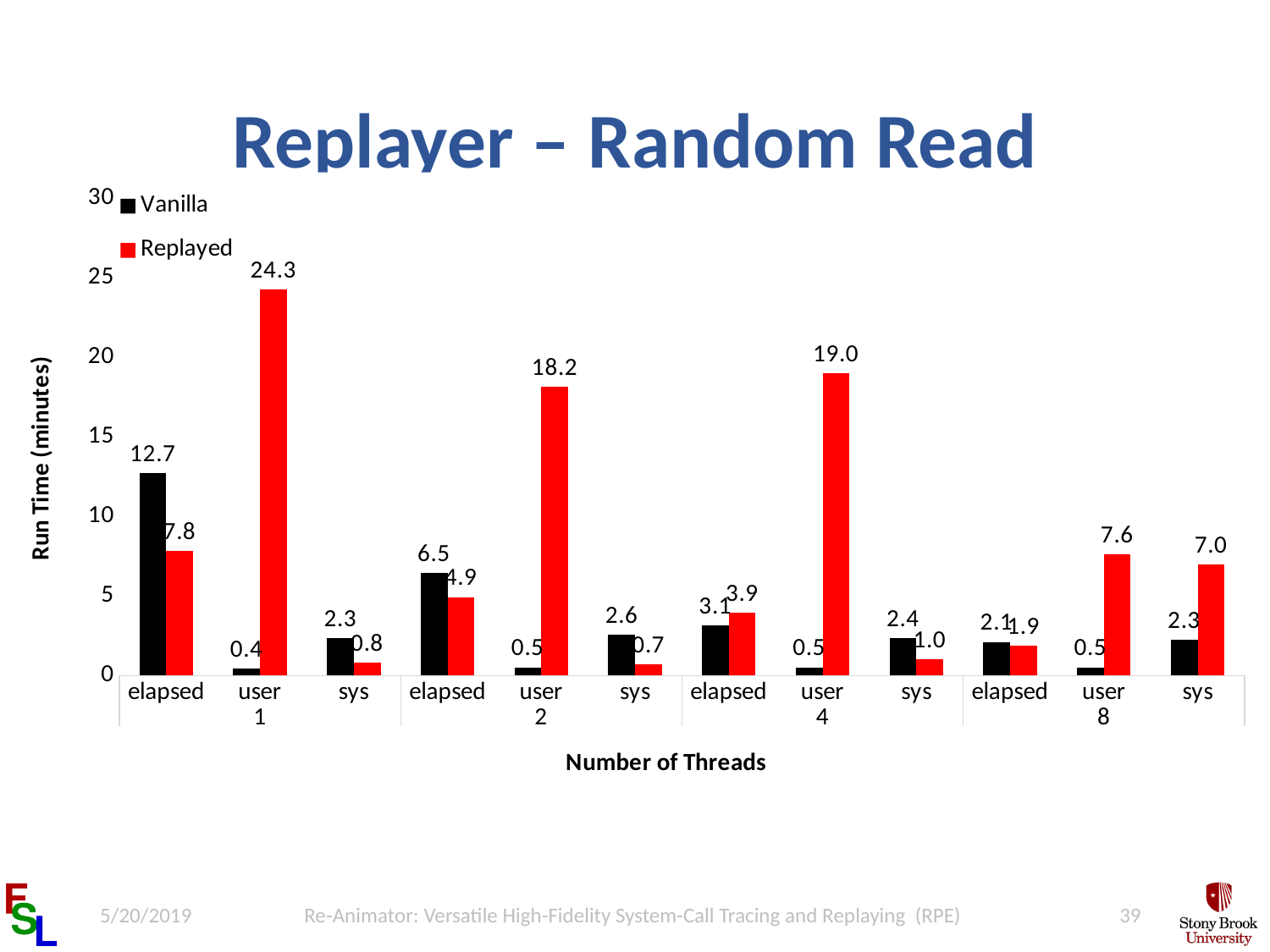
What is the Replayed run time for user at 1 thread? 24.3 What is the Vanilla run time for sys at 2 threads? 2.6 Which category has the highest Replayed run time? user at 1 thread What is the difference between the Vanilla and Replayed elapsed run times at 1 thread? 4.9 What kind of chart is shown on the slide? bar chart What is the difference between the Replayed user run times at 2 threads and 8 threads? 10.6 What is the label of the y axis? Run Time (minutes) Which is larger, the Vanilla or the Replayed elapsed run time at 4 threads? Replayed Is the Replayed user run time at 2 threads greater or less than 15? greater What is the Replayed run time for user at 4 threads? 19.0 How many series does the legend list? 2 What is the Vanilla run time for elapsed at 1 thread? 12.7